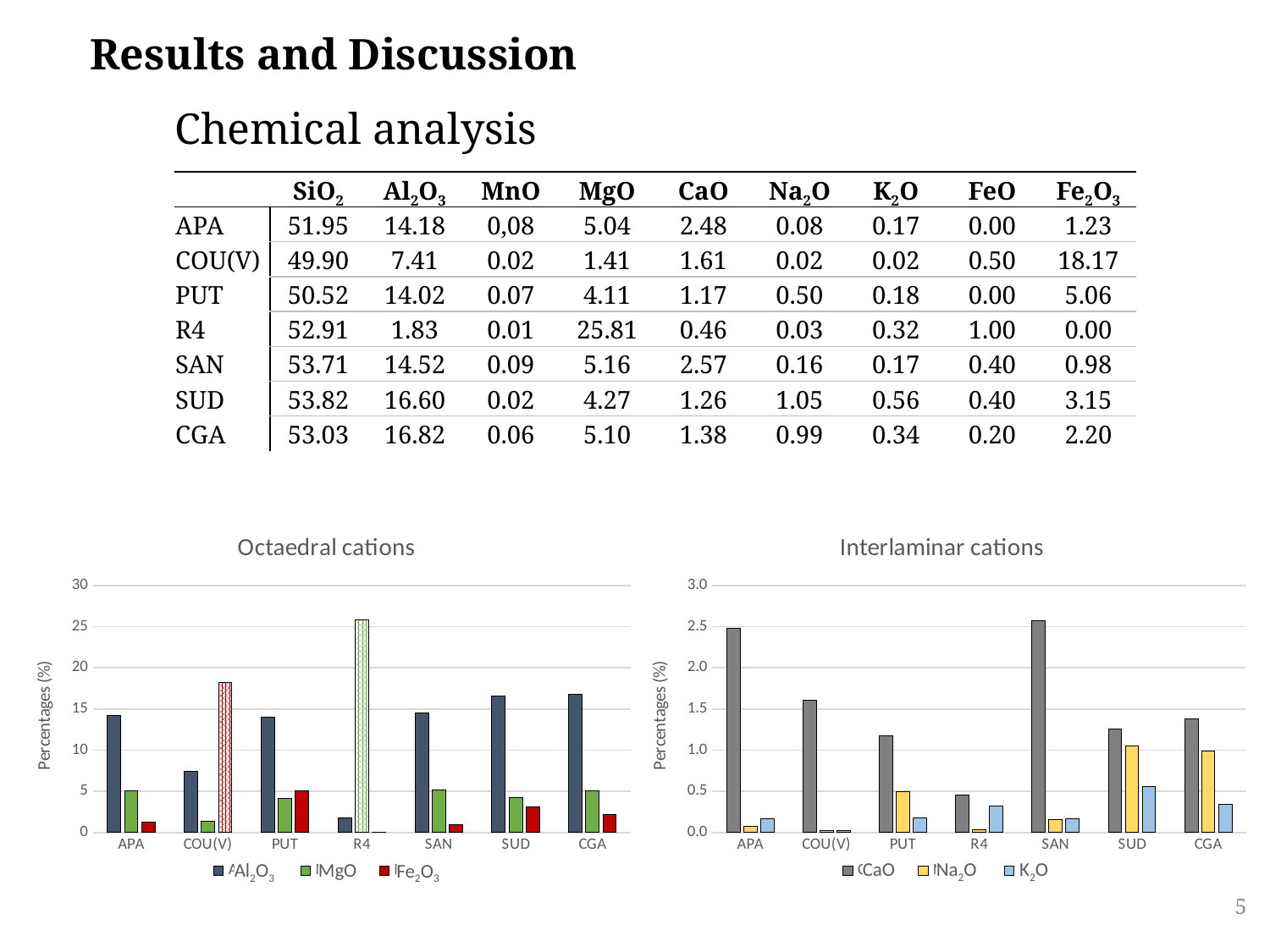
How many series does the legend of the 'Interlaminar cations' chart list? 3 In the 'Octaedral cations' chart, which is larger: the Al2O3 value for SUD or for COU(V)? SUD How many categories are shown on the x axis of the 'Interlaminar cations' chart? 7 What kind of chart is the 'Octaedral cations' chart? bar chart In the 'Interlaminar cations' chart, which category has the lowest CaO value? R4 How many series does the legend of the 'Octaedral cations' chart list? 3 What is the y-axis title of the 'Interlaminar cations' chart? Percentages (%) In the 'Octaedral cations' chart, which category has the highest MgO value? R4 In the 'Octaedral cations' chart, is the Al2O3 value for R4 greater or less than 5? less In the 'Octaedral cations' chart, which category has the highest Fe2O3 value? COU(V) In the 'Octaedral cations' chart, is the MgO value for R4 greater or less than 20? greater In the 'Interlaminar cations' chart, is the CaO value for SAN greater or less than 2.0? greater